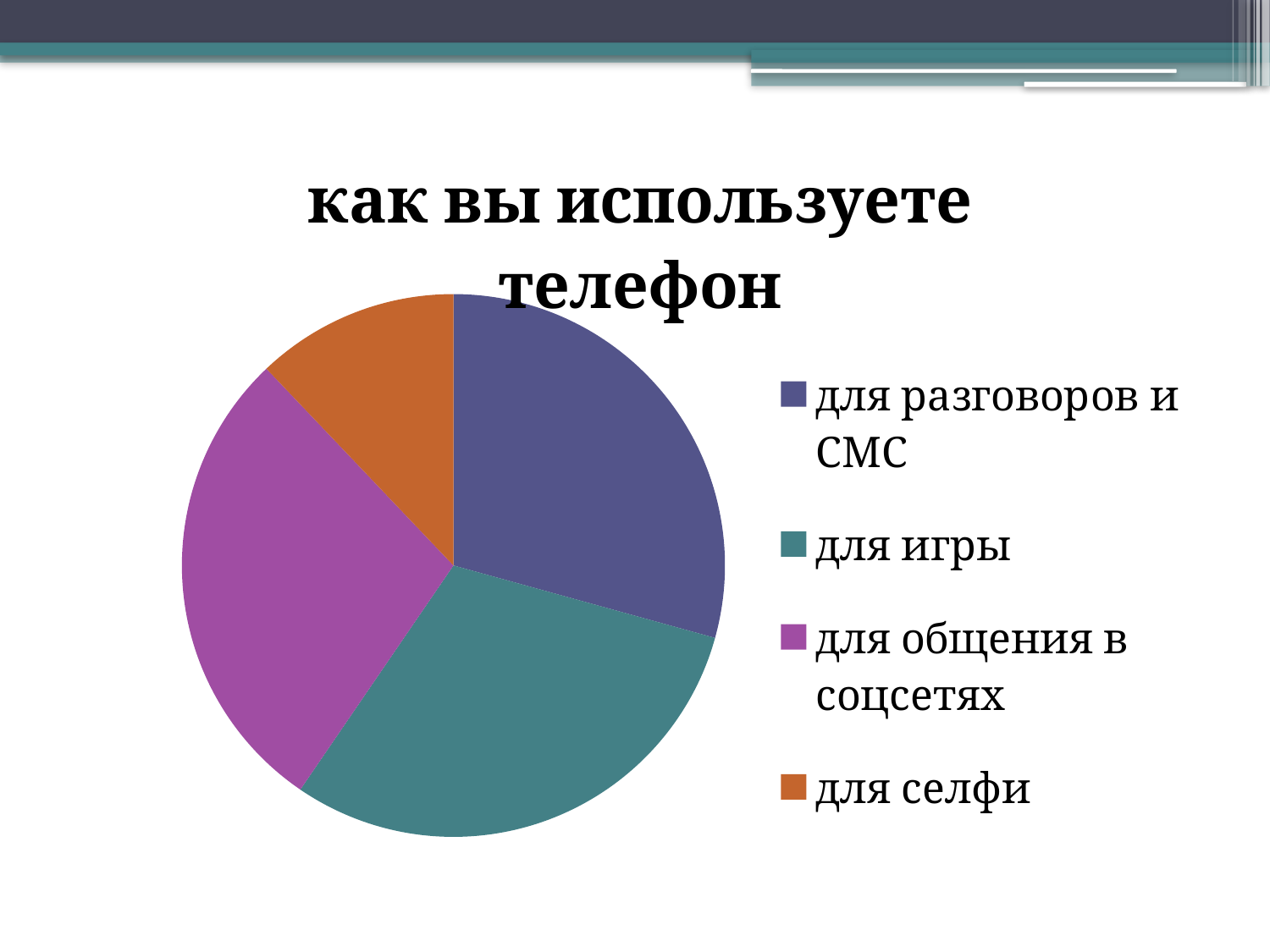
How many entries does the legend list? 4 Which slice is larger: для общения в соцсетях or для селфи? для общения в соцсетях How many slices does the pie chart have? 4 What kind of chart is shown on the slide? pie chart What is the title of the chart? как вы используете телефон Which category has the smallest slice of the pie? для селфи What colour is the slice for для селфи? orange Which slice is larger: для разговоров и СМС or для селфи? для разговоров и СМС Which slice is larger: для селфи or для игры? для игры